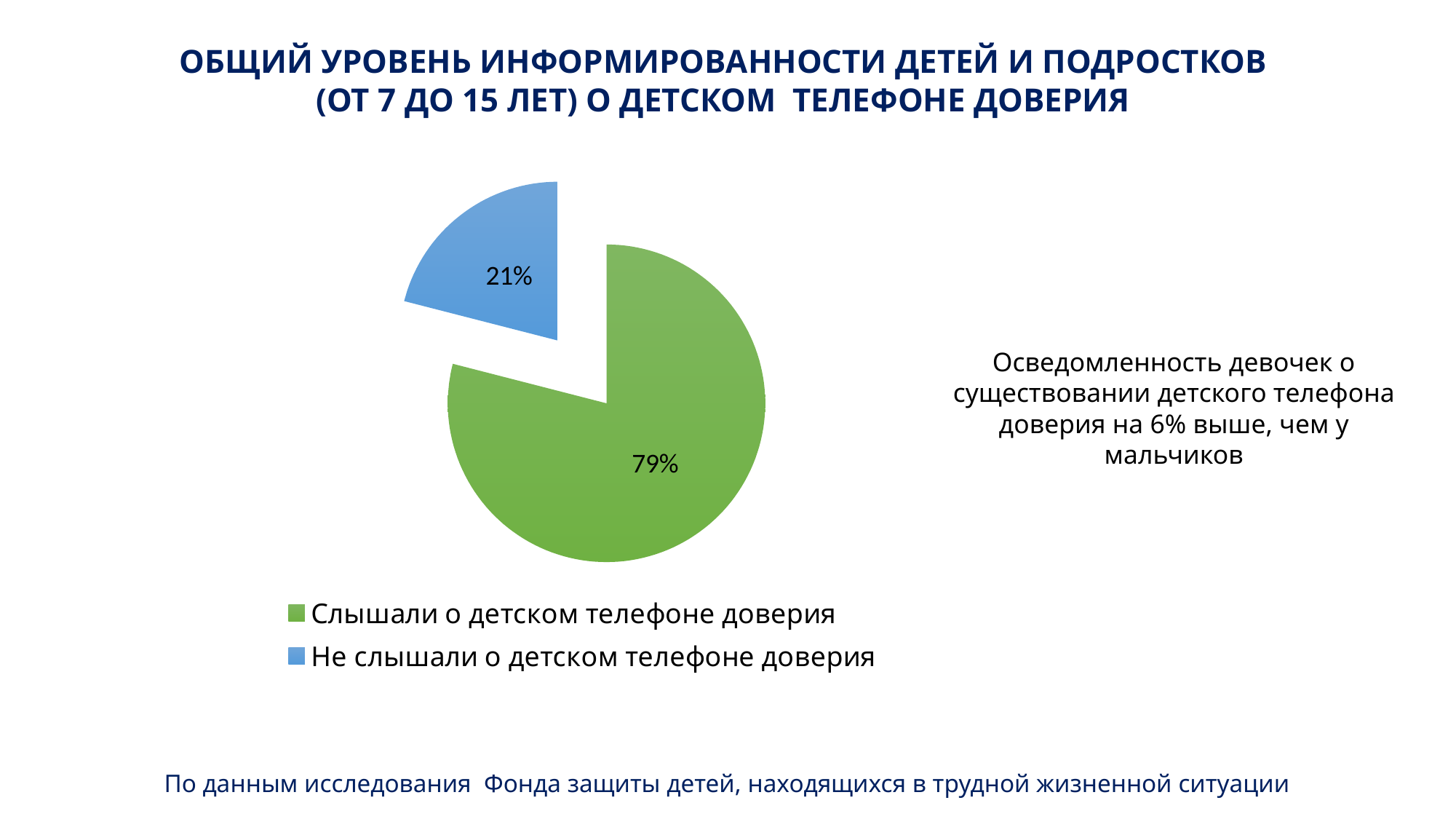
What is the difference in percentage points between the "Слышали" slice and the "Не слышали" slice? 58 How many slices does the pie chart have? 2 Which slice of the pie is the smallest? Не слышали о детском телефоне доверия What share of the pie is labelled "Слышали о детском телефоне доверия"? 79% What kind of chart is shown on the slide? pie chart How many entries does the legend list? 2 Which is larger: the share of children who heard about the helpline or the share who did not? Слышали о детском телефоне доверия What colour is the slice for "Не слышали о детском телефоне доверия"? blue What share of the pie is labelled "Не слышали о детском телефоне доверия"? 21% Which slice of the pie is the largest? Слышали о детском телефоне доверия What colour is the slice for "Слышали о детском телефоне доверия"? green